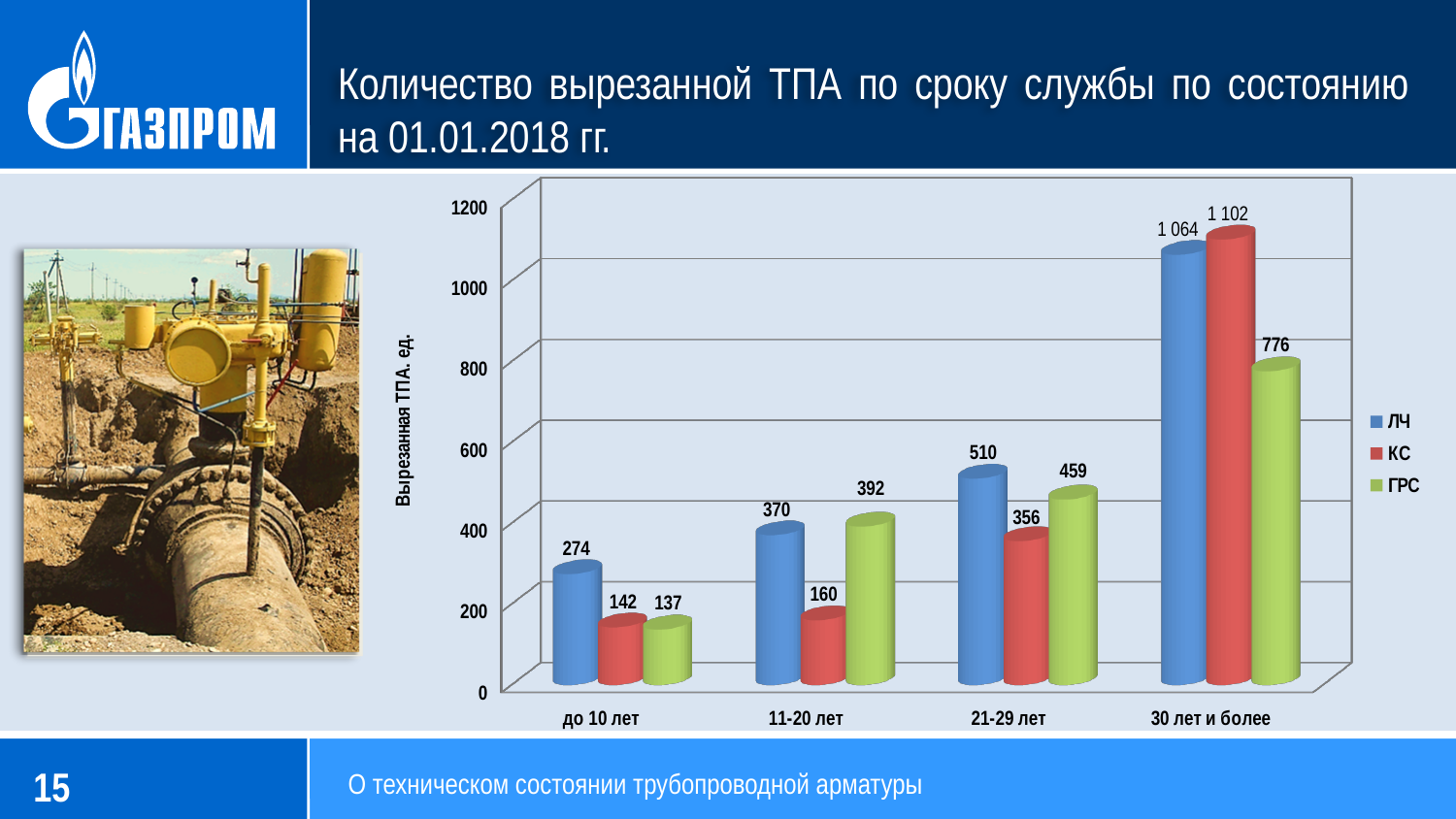
How many series does the legend list? 3 Do the ЛЧ values rise or fall from 'до 10 лет' to '30 лет и более'? rise What kind of chart is shown on the slide? bar chart Which is larger in the '21-29 лет' category, ЛЧ or ГРС? ЛЧ Which category has the lowest value for КС? до 10 лет Is the value for ГРС in the '30 лет и более' category greater or less than 800? less What is the value for ГРС in the '21-29 лет' category? 459 What is the value for ЛЧ in the 'до 10 лет' category? 274 Which category has the highest value for ЛЧ? 30 лет и более How many age categories are shown on the x axis? 4 What is the value for КС in the '30 лет и более' category? 1 102 What is the difference between the ЛЧ and КС values in the '11-20 лет' category? 210